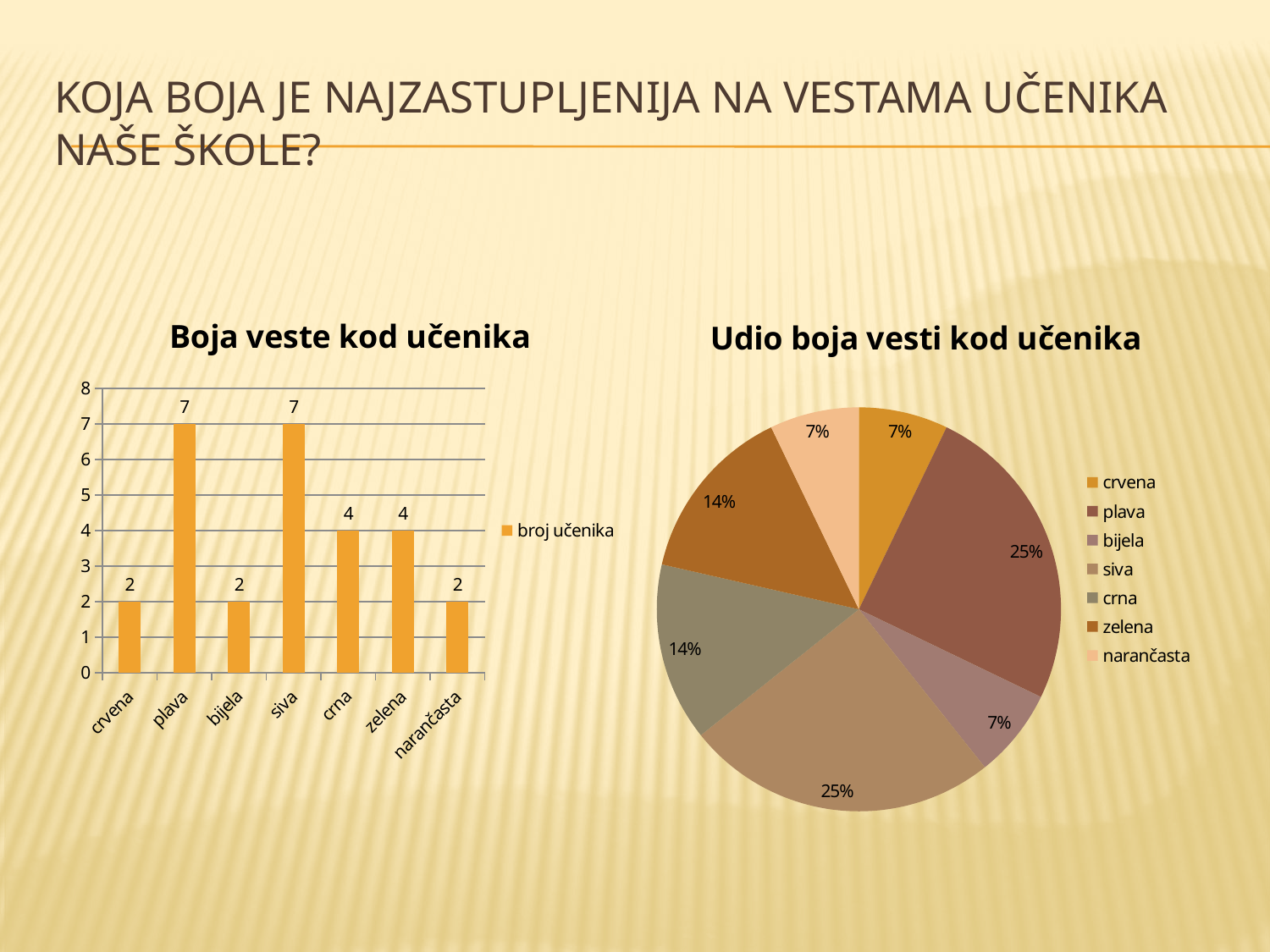
In the bar chart 'Boja veste kod učenika', what is the value for crna? 4 How many slices does the pie chart 'Udio boja vesti kod učenika' have? 7 In the bar chart 'Boja veste kod učenika', what is the value for narančasta? 2 In the bar chart 'Boja veste kod učenika', what is the value for plava? 7 How many categories are shown in the bar chart 'Boja veste kod učenika'? 7 In the pie chart 'Udio boja vesti kod učenika', what share does zelena have? 14% In the pie chart 'Udio boja vesti kod učenika', what share does plava have? 25% How many series does the legend of the bar chart 'Boja veste kod učenika' list? 1 In the bar chart 'Boja veste kod učenika', which has a larger value, zelena or crvena? zelena In the bar chart 'Boja veste kod učenika', what is the difference between the values for siva and bijela? 5 What kind of chart is 'Boja veste kod učenika'? bar chart What is the name of the series in the legend of the bar chart 'Boja veste kod učenika'? broj učenika